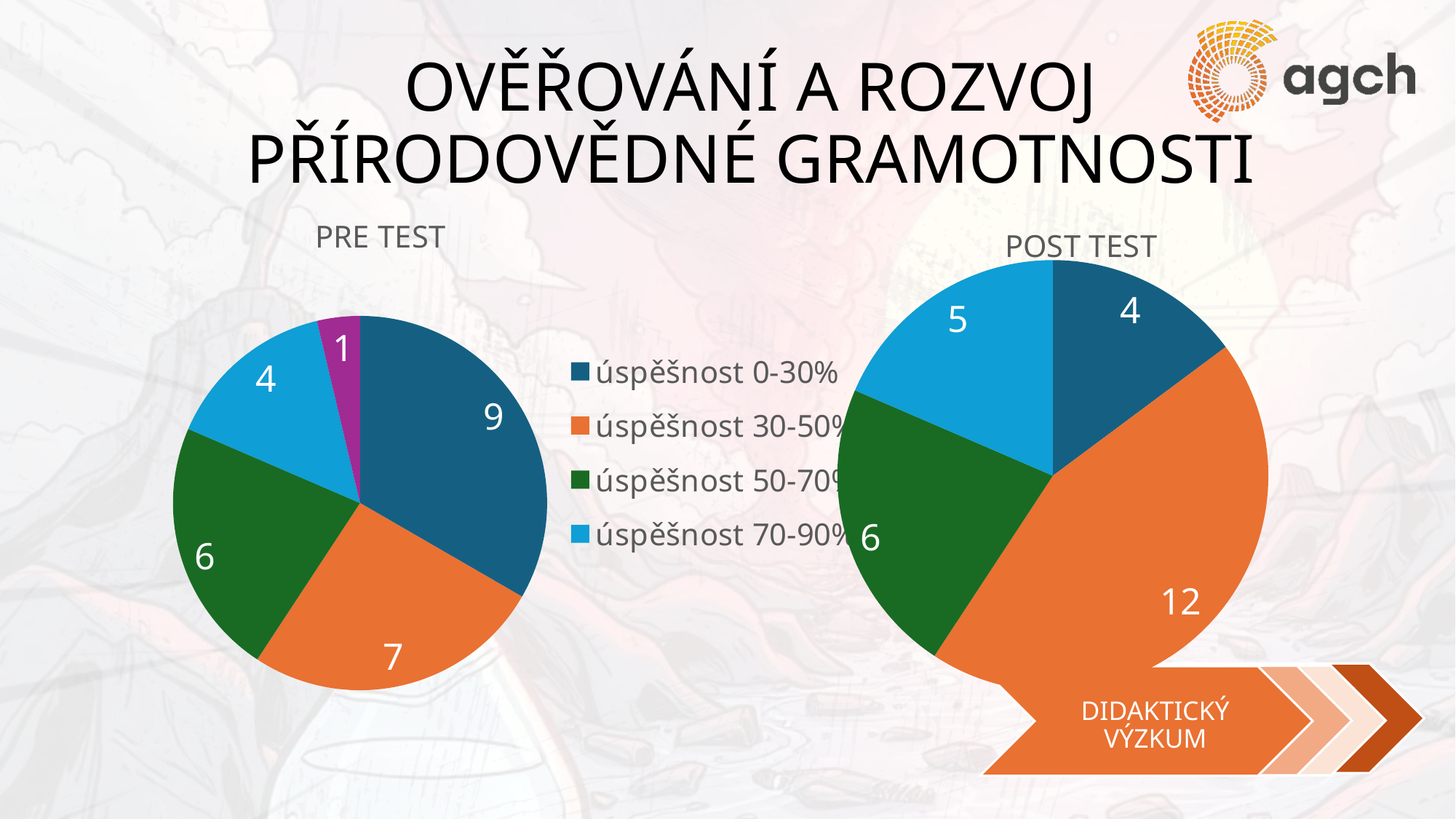
In the POST TEST chart, what is the value for úspěšnost 30-50%? 12 In the POST TEST chart, what is the value for úspěšnost 70-90%? 5 In the POST TEST chart, which category has the largest slice? úspěšnost 30-50% What is the difference between the úspěšnost 30-50% values in the POST TEST and PRE TEST charts? 5 In the POST TEST chart, which category has the smallest slice? úspěšnost 0-30% Which is larger: úspěšnost 0-30% in the PRE TEST chart or in the POST TEST chart? PRE TEST In the PRE TEST chart, what is the value for úspěšnost 0-30%? 9 In the PRE TEST chart, what is the difference between the úspěšnost 0-30% and úspěšnost 70-90% values? 5 How many slices does the POST TEST pie chart have? 4 What kind of chart is the PRE TEST chart? pie chart How many entries does the legend list? 4 In the PRE TEST chart, which legend category has the largest slice? úspěšnost 0-30%